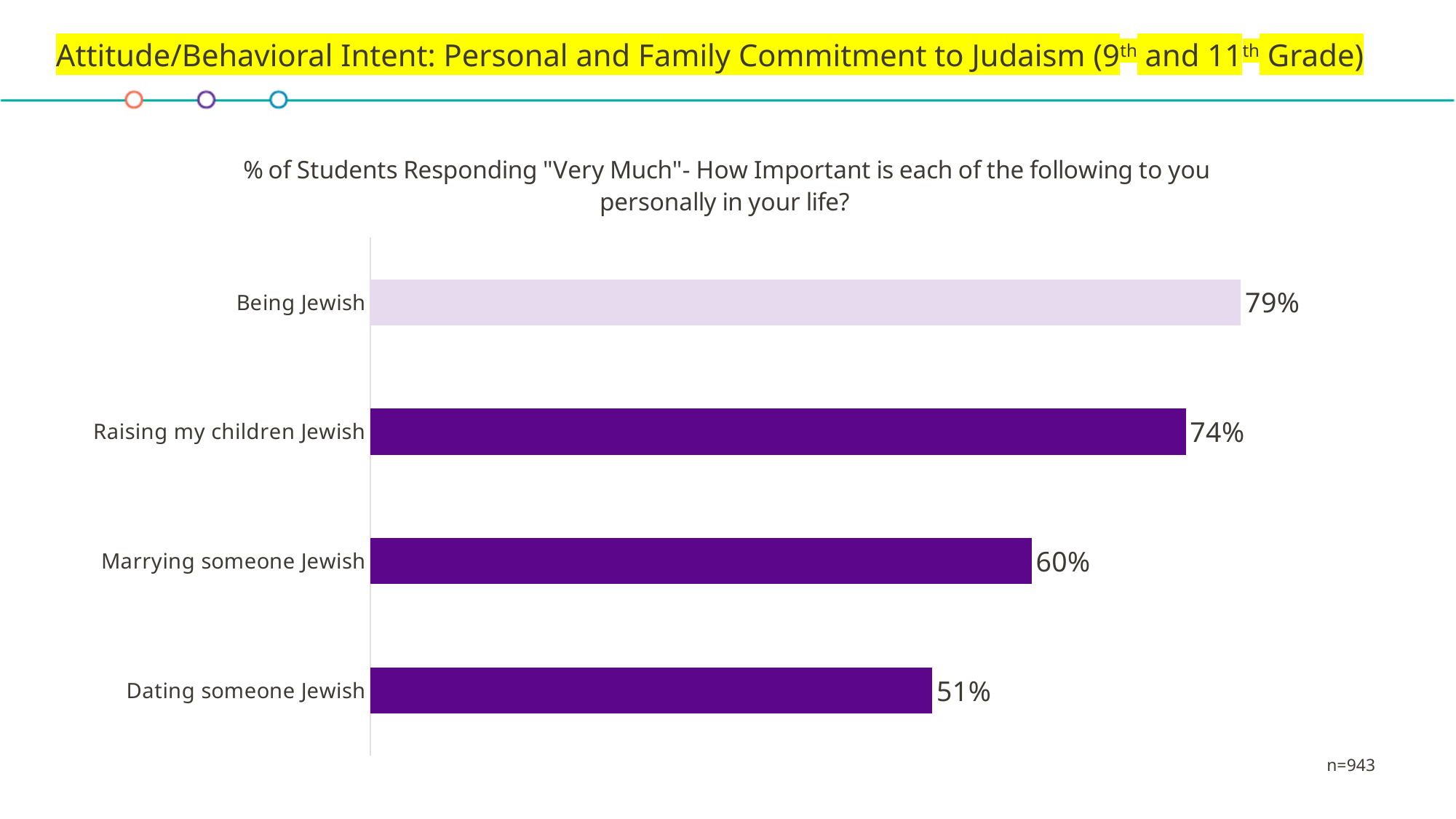
Which category has the lowest percentage? Dating someone Jewish Which category has the highest percentage? Being Jewish How many categories are shown in the chart? 4 What is the value shown for Dating someone Jewish? 51% What is the difference in percentage points between Being Jewish and Dating someone Jewish? 28 What is the difference in percentage points between Raising my children Jewish and Marrying someone Jewish? 14 What percentage of students responded "Very Much" for Being Jewish? 79% What is the value shown for Marrying someone Jewish? 60% What kind of chart is shown on the slide? Bar chart What sample size (n) is noted on the slide? n=943 Which is larger, the value for Marrying someone Jewish or the value for Dating someone Jewish? Marrying someone Jewish What is the value shown for Raising my children Jewish? 74%